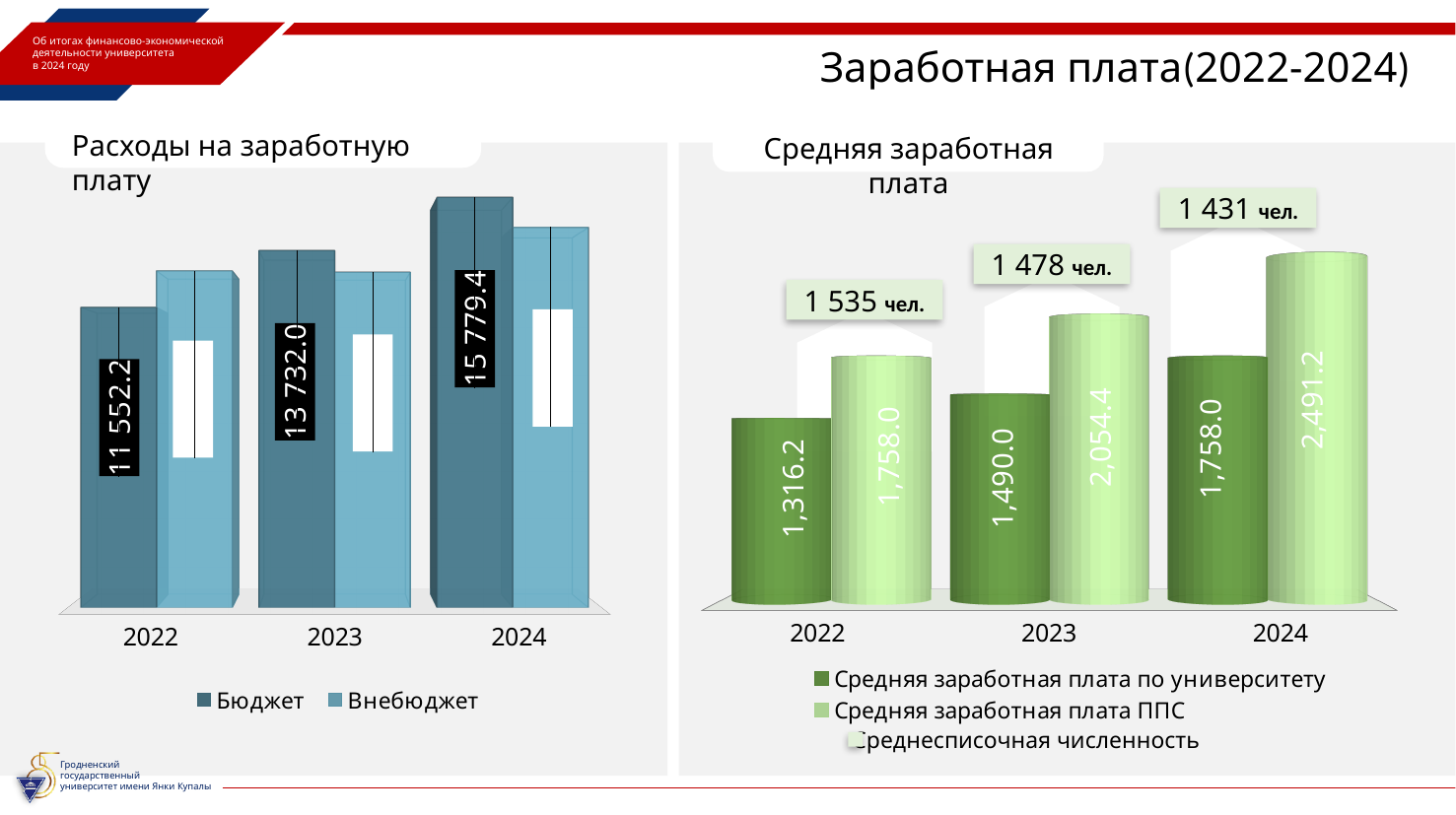
In the Средняя заработная плата chart, what is the Среднесписочная численность for 2024? 1 431 чел. In the Расходы на заработную плату chart, what value is printed for 2024? 15 779.4 What kind of chart is the Расходы на заработную плату chart? bar chart In the Средняя заработная плата chart, does the Среднесписочная численность rise or fall from 2022 to 2024? fall In the Средняя заработная плата chart, what is the Средняя заработная плата по университету value for 2022? 1,316.2 How many series does the legend of the Средняя заработная плата chart list? 3 In the Расходы на заработную плату chart, what is the difference between the values printed for 2024 and 2022? 4 227.2 In the Средняя заработная плата chart, what is the difference between Средняя заработная плата ППС and Средняя заработная плата по университету in 2024? 733.2 How many years are shown on the x axis of the Расходы на заработную плату chart? 3 In the Расходы на заработную плату chart, which bar is taller in 2024, Бюджет or Внебюджет? Бюджет In the Средняя заработная плата chart, which year has the highest Средняя заработная плата ППС? 2024 In the Средняя заработная плата chart, what is the Средняя заработная плата ППС value for 2023? 2,054.4